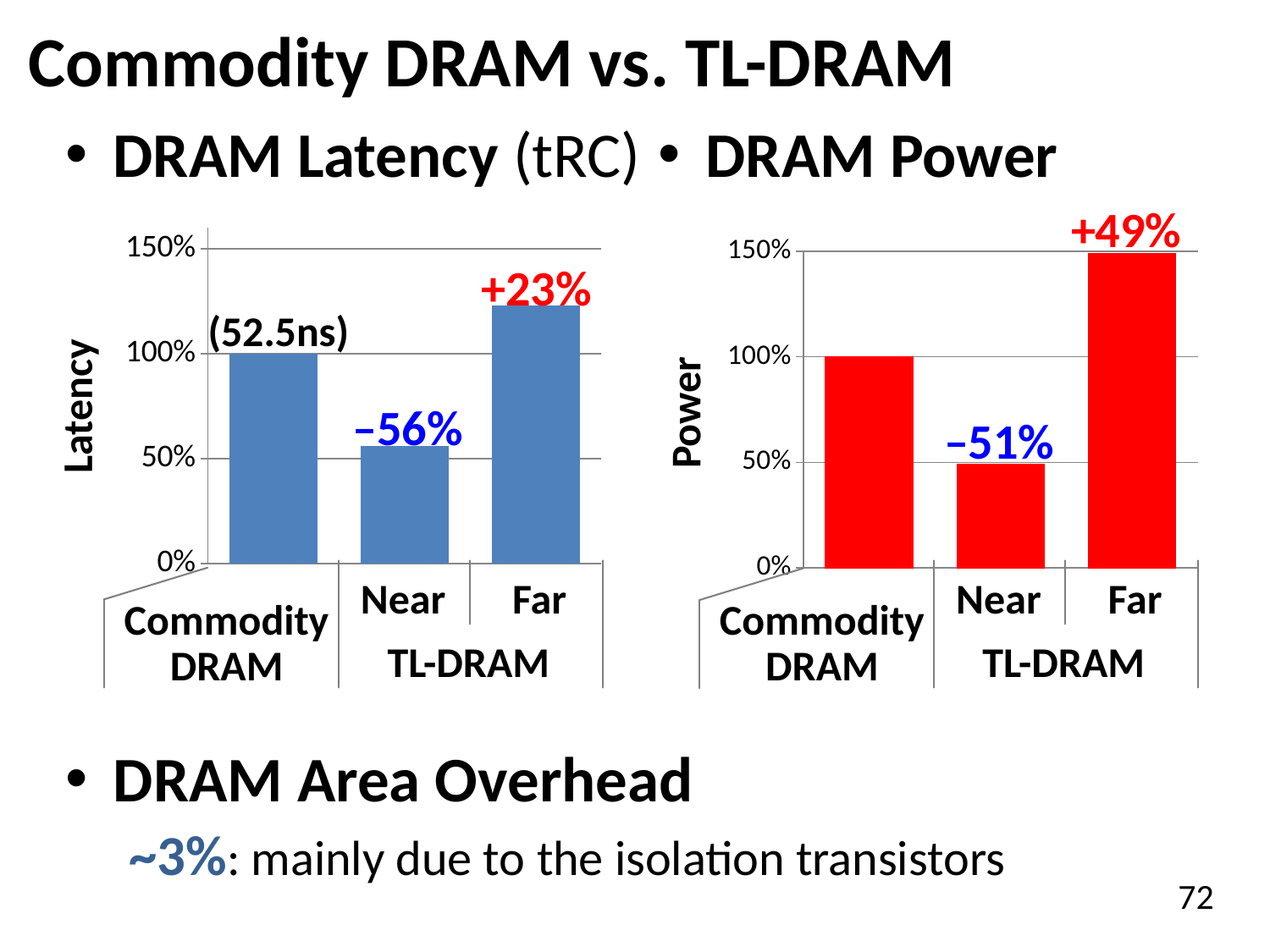
In the DRAM Latency chart, what absolute latency is annotated for Commodity DRAM? 52.5ns In the DRAM Latency chart, how many bars are plotted? 3 In the DRAM Latency chart, what is the latency value for Commodity DRAM? 100% In the DRAM Latency chart, what percentage change is annotated above the TL-DRAM Near bar? –56% In the DRAM Power chart, what percentage change is annotated above the TL-DRAM Far bar? +49% What colour are the bars in the DRAM Power chart? red In the DRAM Latency chart, is the value for TL-DRAM Far greater or less than 100%? greater In the DRAM Power chart, what is the power value for Commodity DRAM? 100% What kind of chart is the DRAM Latency chart on the left? bar chart In the DRAM Latency chart, what percentage change is annotated above the TL-DRAM Far bar? +23% In the DRAM Power chart, which bar is the highest? Far (TL-DRAM) In the DRAM Latency chart, which bar is the lowest? Near (TL-DRAM)